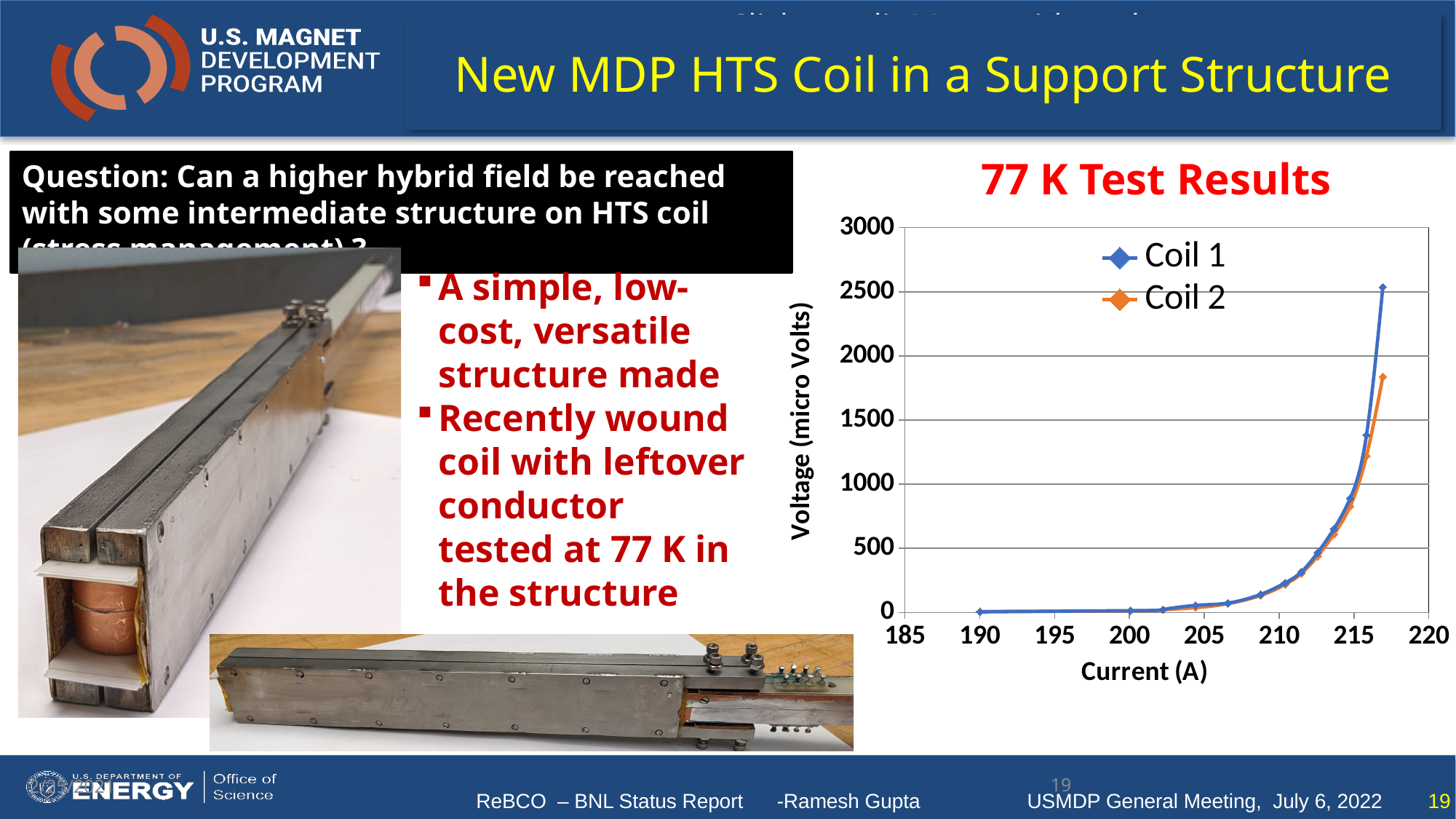
What is the title of the chart on the slide? 77 K Test Results In the "77 K Test Results" chart, is the voltage of Coil 1 at 210 A greater or less than 500? less In the "77 K Test Results" chart, is the highest voltage reached by Coil 1 greater or less than 2000? greater How many series does the legend of the "77 K Test Results" chart list? 2 What is the label of the y axis of the "77 K Test Results" chart? Voltage (micro Volts) In the "77 K Test Results" chart, is the highest voltage reached by Coil 2 greater or less than 2000? less In the "77 K Test Results" chart, does the voltage rise or fall as current increases? rise In the "77 K Test Results" chart, which series reaches the higher voltage at its highest current, Coil 1 or Coil 2? Coil 1 What kind of chart is the "77 K Test Results" chart? line chart In the "77 K Test Results" chart, which series reaches the lower maximum voltage? Coil 2